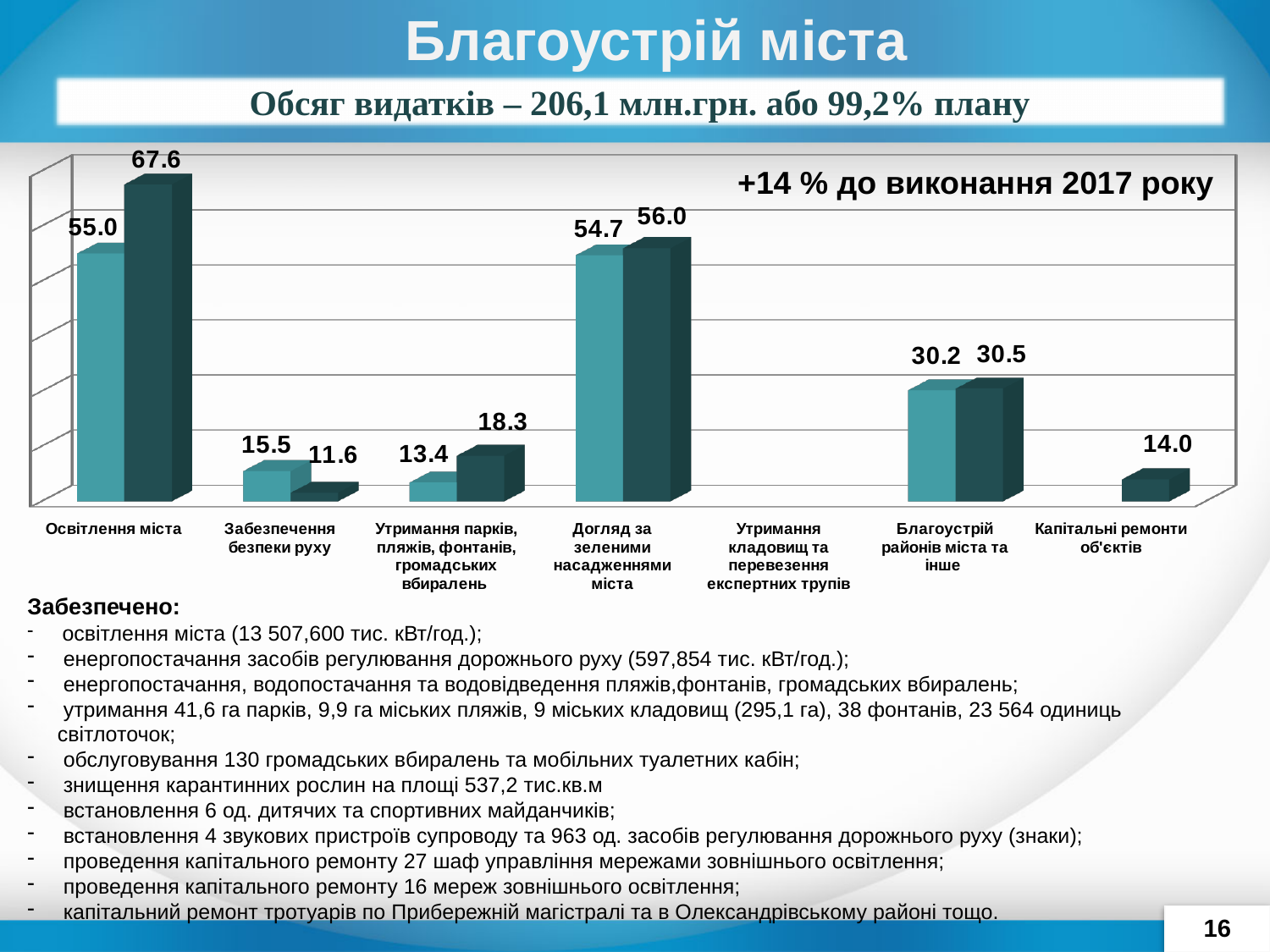
What is the value shown for Капітальні ремонти об'єктів? 14.0 What text is shown in the box at the top right of the chart? +14 % до виконання 2017 року Which category has the highest value in the chart? Освітлення міста What is the value of the darker (back) bar for Забезпечення безпеки руху? 11.6 What is the value of the lighter (front) bar for Догляд за зеленими насадженнями міста? 54.7 What is the value of the darker (back) bar for Освітлення міста? 67.6 Which is larger for Утримання парків, пляжів, фонтанів, громадських вбиралень: the lighter (front) bar or the darker (back) bar? the darker (back) bar What is the difference between the darker bar (18.3) and the lighter bar (13.4) for Утримання парків, пляжів, фонтанів, громадських вбиралень? 4.9 What is the value of the lighter (front) bar for Освітлення міста? 55.0 How many categories are labelled on the x axis of the chart? 7 What is the difference between the darker and lighter bars for Освітлення міста? 12.6 What kind of chart is shown on the slide? bar chart